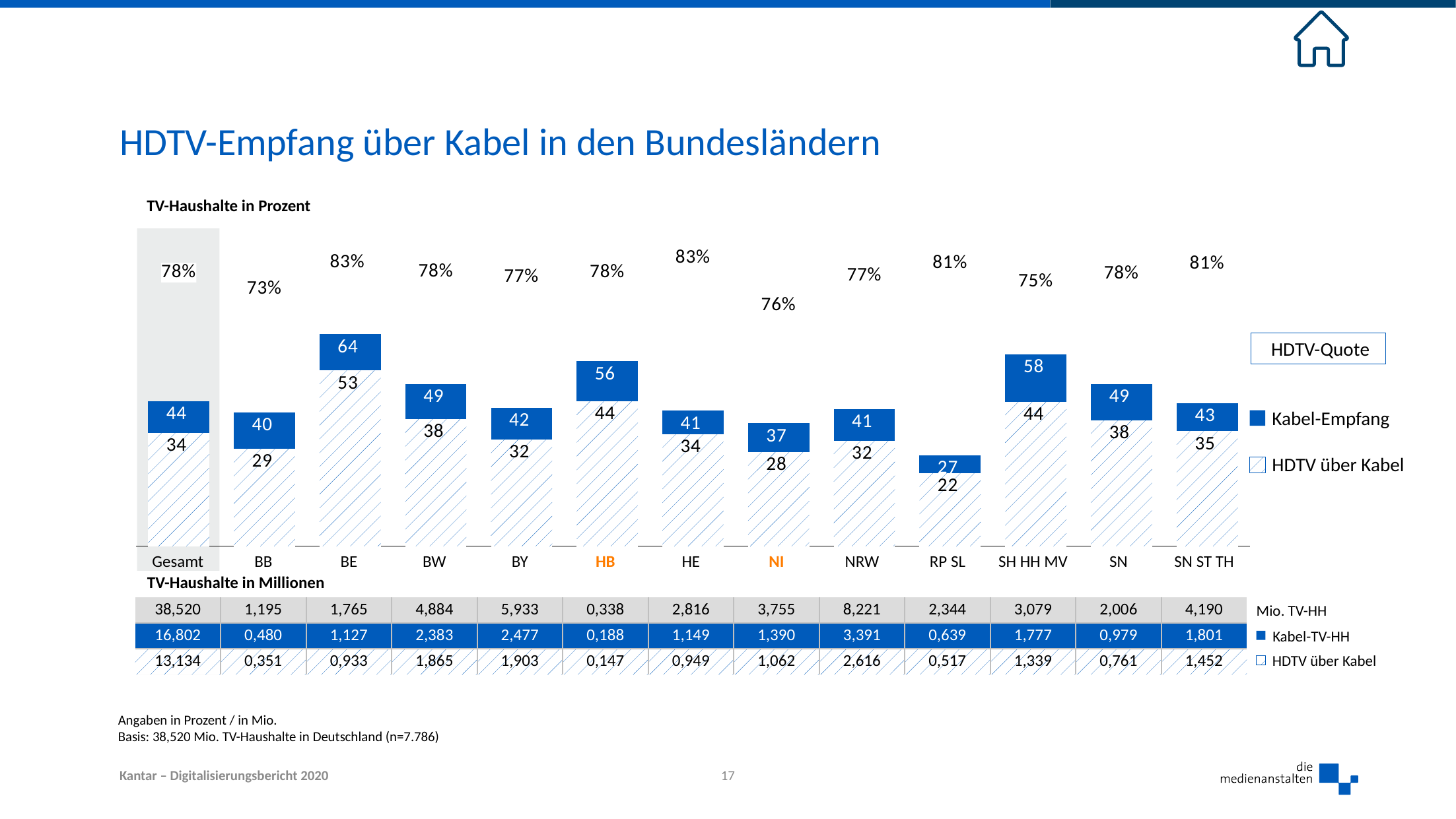
What kind of chart is shown on the slide? bar chart What is the HDTV über Kabel value for NRW? 32 Which category has the highest Kabel-Empfang value? BE Which category has the lowest HDTV-Quote? BB How many categories are shown on the x axis of the chart? 13 What is the difference between the Kabel-Empfang value and the HDTV über Kabel value for BE? 11 What is the HDTV-Quote shown for BB? 73% What is the Kabel-Empfang value for BE? 64 Which category has the lowest HDTV über Kabel value? RP SL Which has the larger Kabel-Empfang value, BW or NI? BW What is the difference between the Kabel-Empfang values for BE and RP SL? 37 How many series does the chart legend list? 2